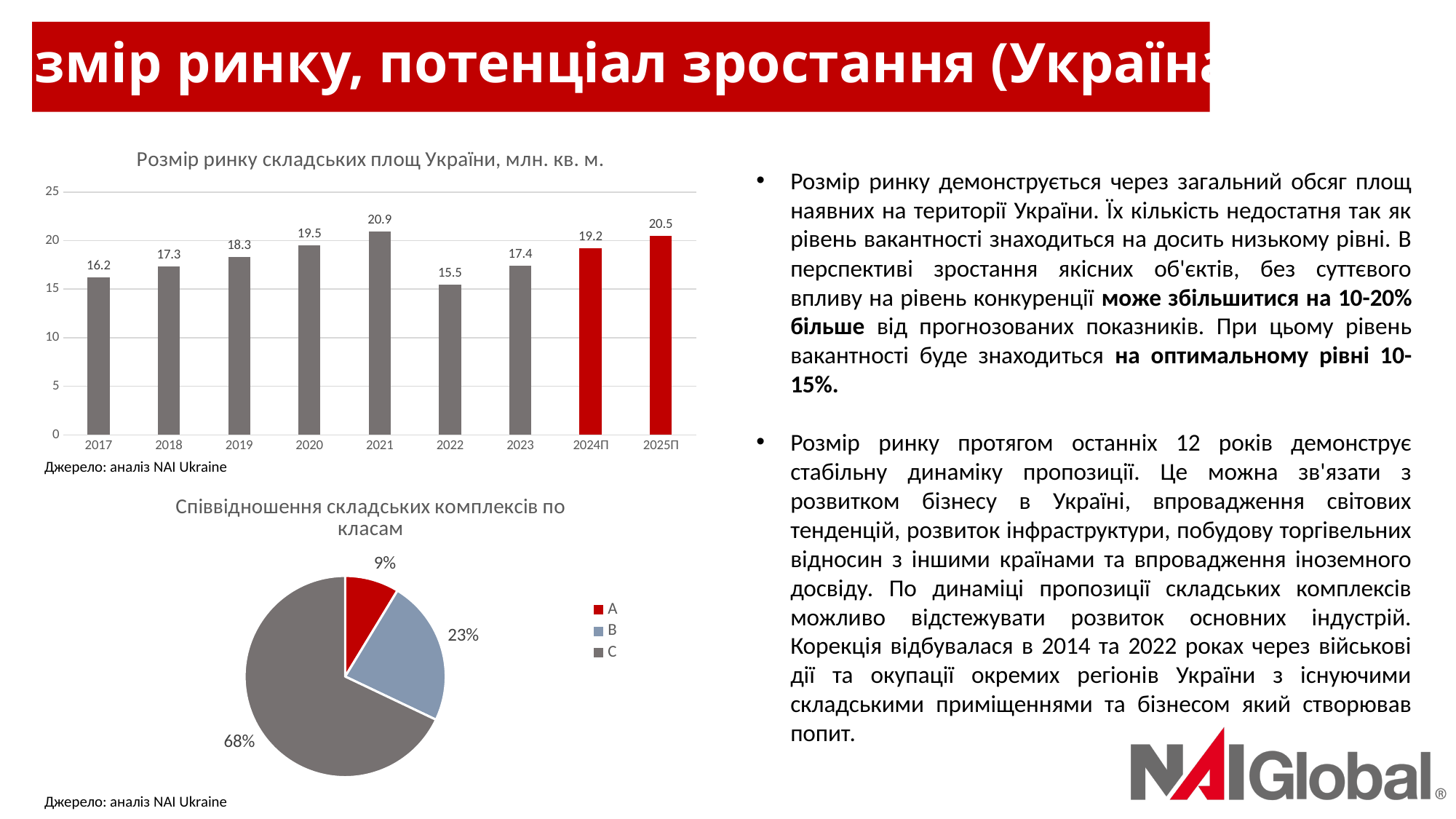
In the bar chart 'Розмір ринку складських площ України, млн. кв. м.', what is the value for 2021? 20.9 What kind of chart is the top chart on the slide? bar chart In the bar chart 'Розмір ринку складських площ України, млн. кв. м.', which year has the highest value? 2021 In the bar chart 'Розмір ринку складських площ України, млн. кв. м.', which year has the lowest value? 2022 In the bar chart 'Розмір ринку складських площ України, млн. кв. м.', which is larger, the value for 2020 or the value for 2023? 2020 In the pie chart 'Співвідношення складських комплексів по класам', which class has the smallest share? A In the bar chart 'Розмір ринку складських площ України, млн. кв. м.', what is the difference between the values for 2021 and 2022? 5.4 In the pie chart 'Співвідношення складських комплексів по класам', how many entries does the legend list? 3 In the bar chart 'Розмір ринку складських площ України, млн. кв. м.', how many years are shown on the x axis? 9 In the bar chart 'Розмір ринку складських площ України, млн. кв. м.', what is the value for 2025П? 20.5 In the bar chart 'Розмір ринку складських площ України, млн. кв. м.', do the values rise or fall from 2017 to 2021? rise In the pie chart 'Співвідношення складських комплексів по класам', what share does class C have? 68%